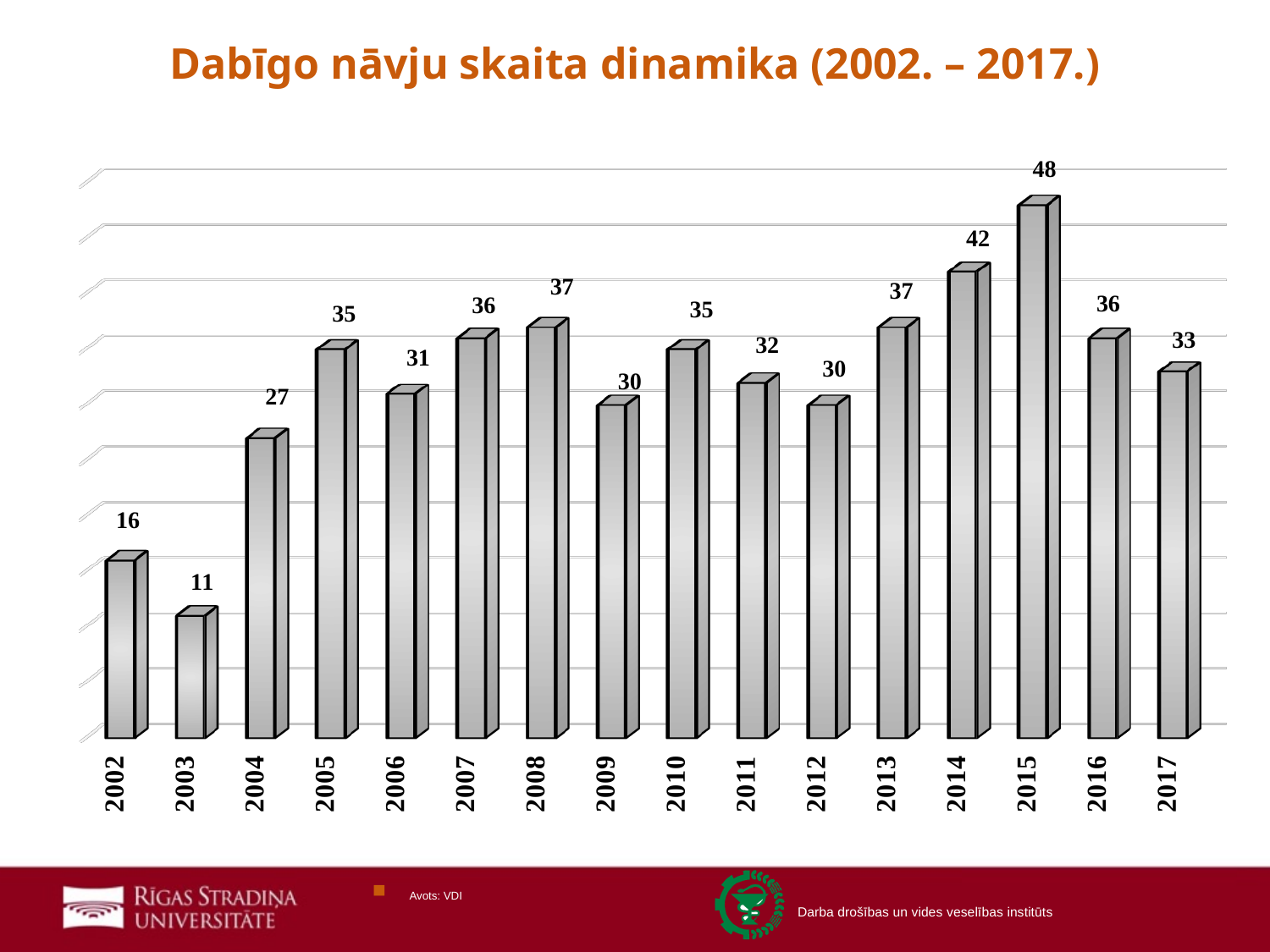
What is the difference between the values for 2004 and 2003? 16 What kind of chart is shown on the slide? bar chart Which year has the lowest value? 2003 Which is larger, the value for 2008 or the value for 2009? 2008 Do the values rise or fall from 2012 to 2015? rise What is the title of the chart? Dabīgo nāvju skaita dinamika (2002. – 2017.) What is the value for 2015? 48 What is the value for 2010? 35 How many years are shown on the x axis? 16 Which year has the highest value? 2015 What is the value for 2003? 11 What is the difference between the values for 2015 and 2014? 6